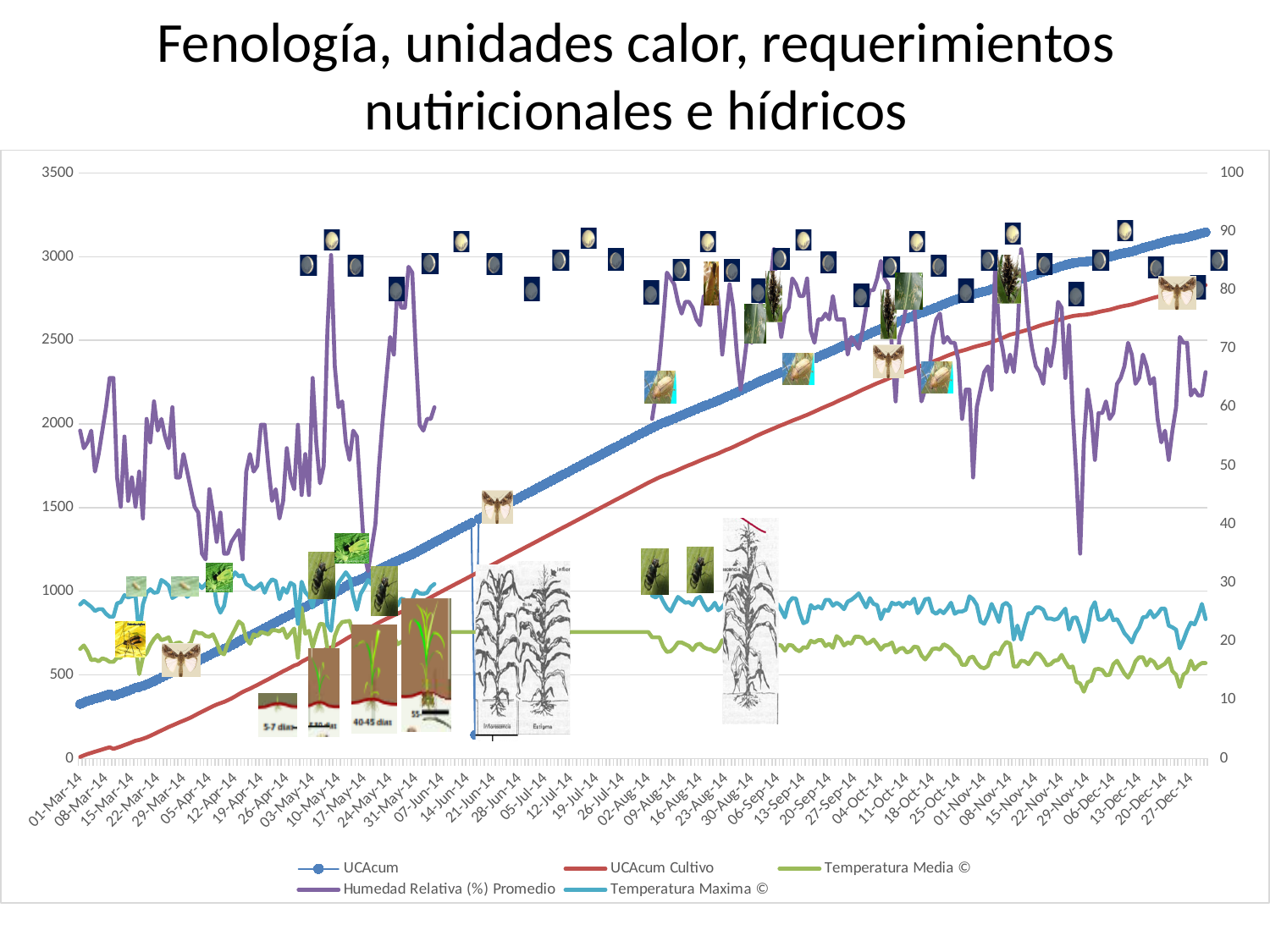
Which series is drawn in red? UCAcum Cultivo Is the value of Temperatura Media at the end of the series (27-Dec-14) greater or less than 20 on the right axis? less Is the value of UCAcum at 01-Mar-14 greater or less than 500 on the left axis? less How many series does the legend list? 5 What is the title of the slide? Fenología, unidades calor, requerimientos nutiricionales e hídricos Does the UCAcum series rise or fall along the x axis from 01-Mar-14 to 27-Dec-14? rise At 27-Dec-14, which is larger: UCAcum or UCAcum Cultivo? UCAcum Does the UCAcum Cultivo series rise or fall along the x axis? rise Which series is higher throughout the chart: Temperatura Maxima or Temperatura Media? Temperatura Maxima Is the value of UCAcum Cultivo at the end of the series (27-Dec-14) greater or less than 2500 on the left axis? greater What kind of chart is shown on the slide? line chart